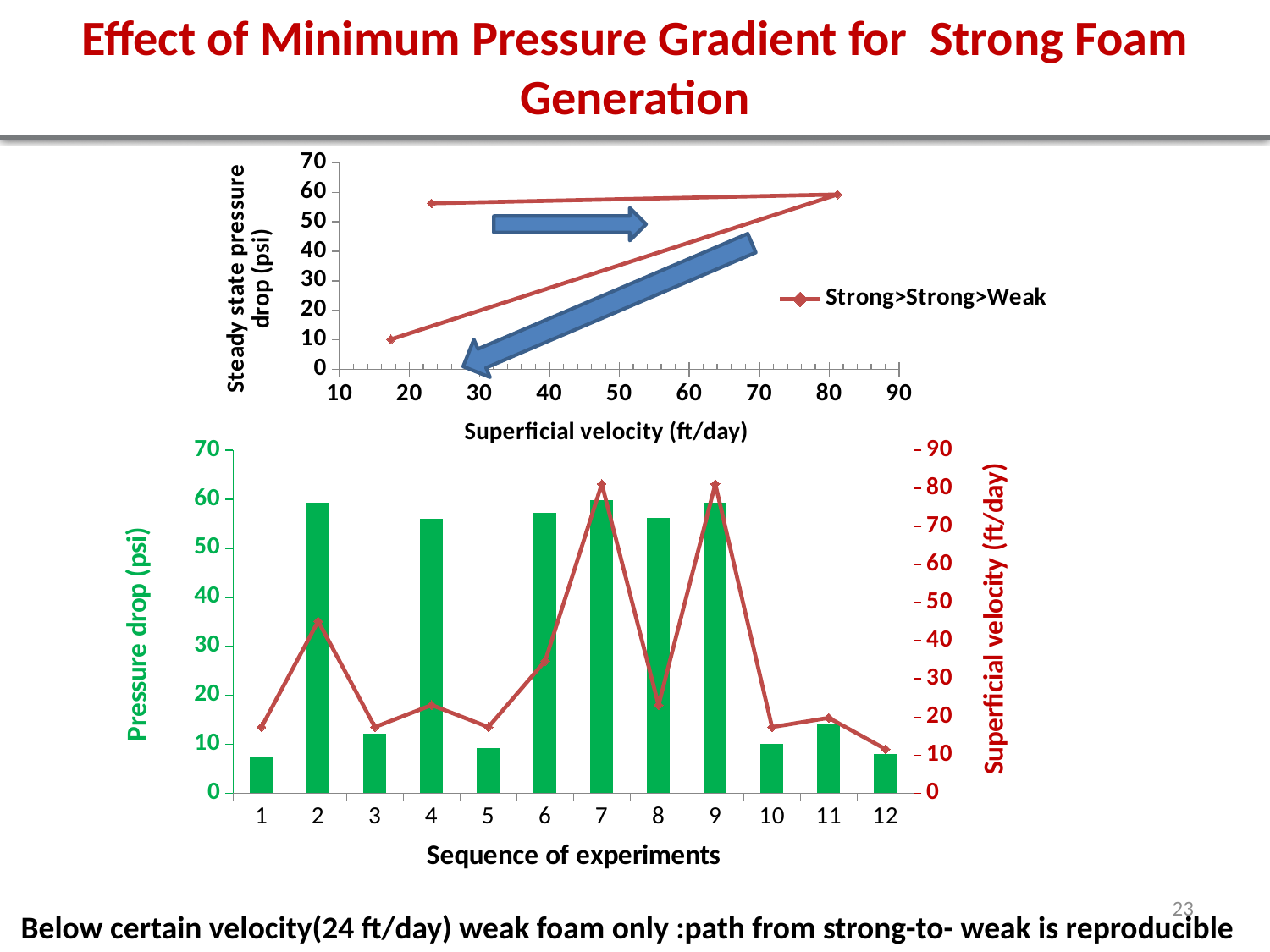
In the bottom chart, is the superficial velocity line value for experiment 7 greater or less than 70? greater In the top chart, is the steady state pressure drop for the point at the highest superficial velocity greater or less than 50? greater In the bottom chart, is the superficial velocity line value for experiment 8 greater or less than 30? less What is the x-axis title of the bottom chart? Sequence of experiments What kind of chart is the top chart titled with the legend 'Strong>Strong>Weak'? line chart In the bottom chart, which has the larger pressure drop bar, experiment 4 or experiment 5? experiment 4 In the bottom chart, which has the larger pressure drop bar, experiment 6 or experiment 10? experiment 6 What is the legend entry shown in the top chart? Strong>Strong>Weak In the bottom chart, how many experiments are shown along the x axis? 12 In the top chart, how many data points are plotted on the line? 3